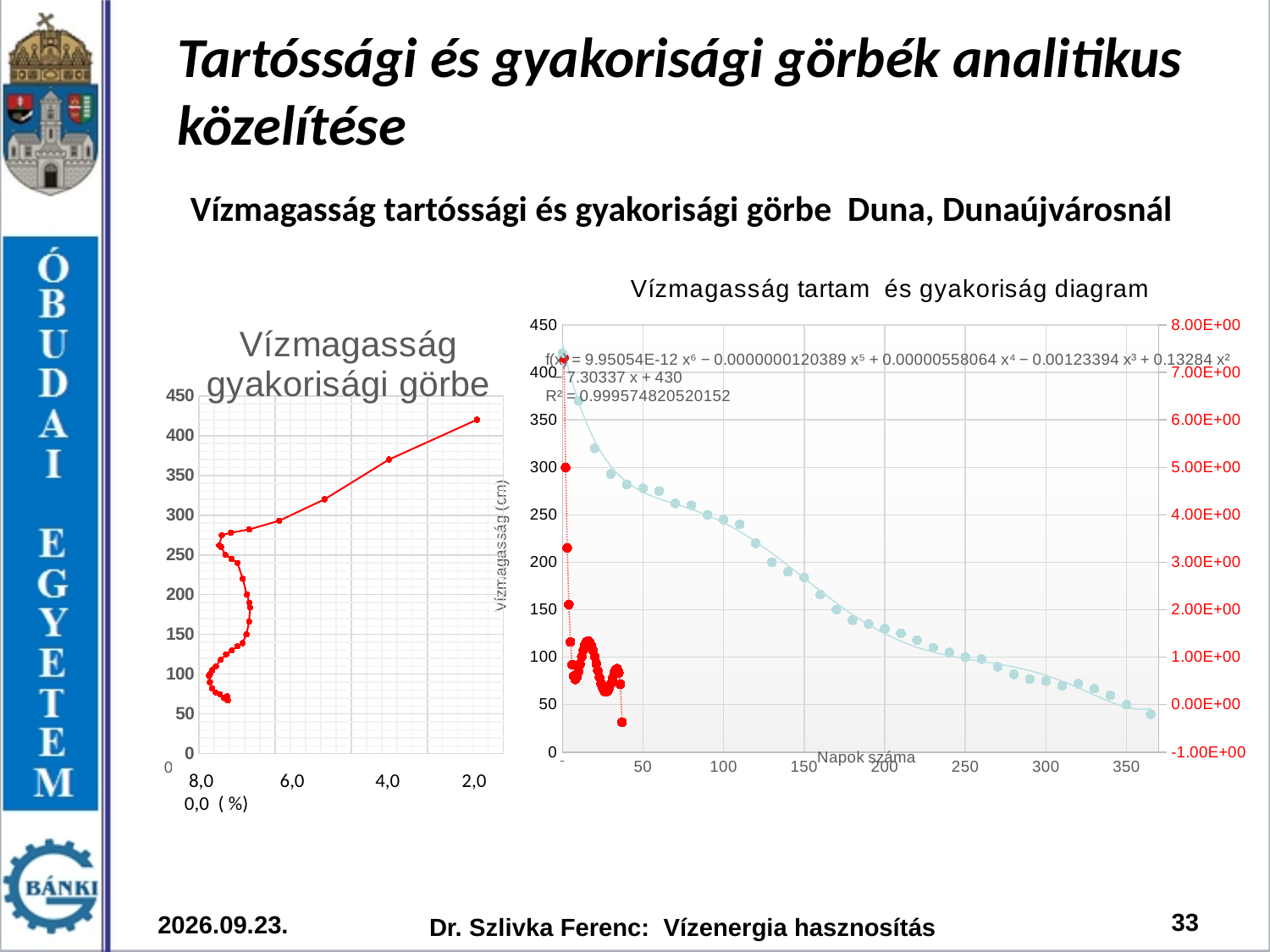
How many charts are shown on the slide? 2 In the 'Vízmagasság gyakorisági görbe' chart on the left, is the lowest point on the curve greater or less than 100? less What is the title of the chart on the left of the slide? Vízmagasság gyakorisági görbe What kind of chart is the 'Vízmagasság tartam és gyakoriság diagram' on the right of the slide? line chart In the 'Vízmagasság tartam és gyakoriság diagram' chart, is the light blue value at 50 days greater or less than 250? greater What is the x-axis label of the 'Vízmagasság tartam és gyakoriság diagram' chart? Napok száma In the 'Vízmagasság tartam és gyakoriság diagram' chart, is the light blue value at 200 days greater or less than 100? greater What is the maximum value shown on the left vertical axis of the 'Vízmagasság tartam és gyakoriság diagram' chart? 450 In the 'Vízmagasság tartam és gyakoriság diagram' chart, do the light blue points rise or fall as the number of days increases along the x axis? fall